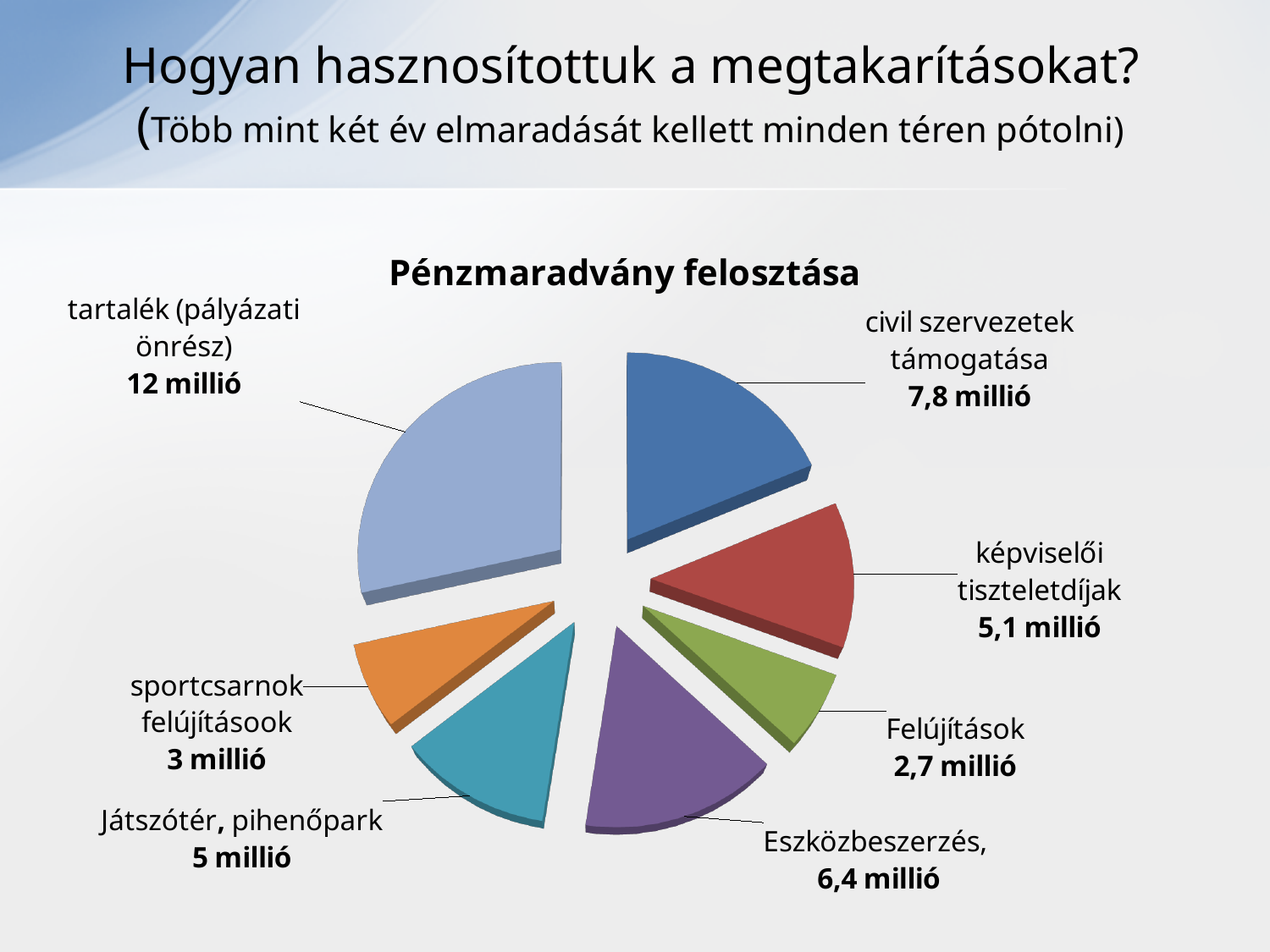
Which is larger, képviselői tiszteletdíjak or Játszótér, pihenőpark? képviselői tiszteletdíjak What is the value for Eszközbeszerzés? 6,4 millió What is the difference between tartalék (pályázati önrész) and civil szervezetek támogatása? 4,2 millió What is the total of all slices in the pie chart? 42 millió What is the difference between Eszközbeszerzés and Játszótér, pihenőpark? 1,4 millió What is the value for civil szervezetek támogatása? 7,8 millió Which category has the largest slice? tartalék (pályázati önrész) Which category has the smallest slice? Felújítások What is the title of the chart? Pénzmaradvány felosztása What is the value for sportcsarnok felújításook? 3 millió How many slices does the pie chart have? 7 What kind of chart is shown on the slide? pie chart